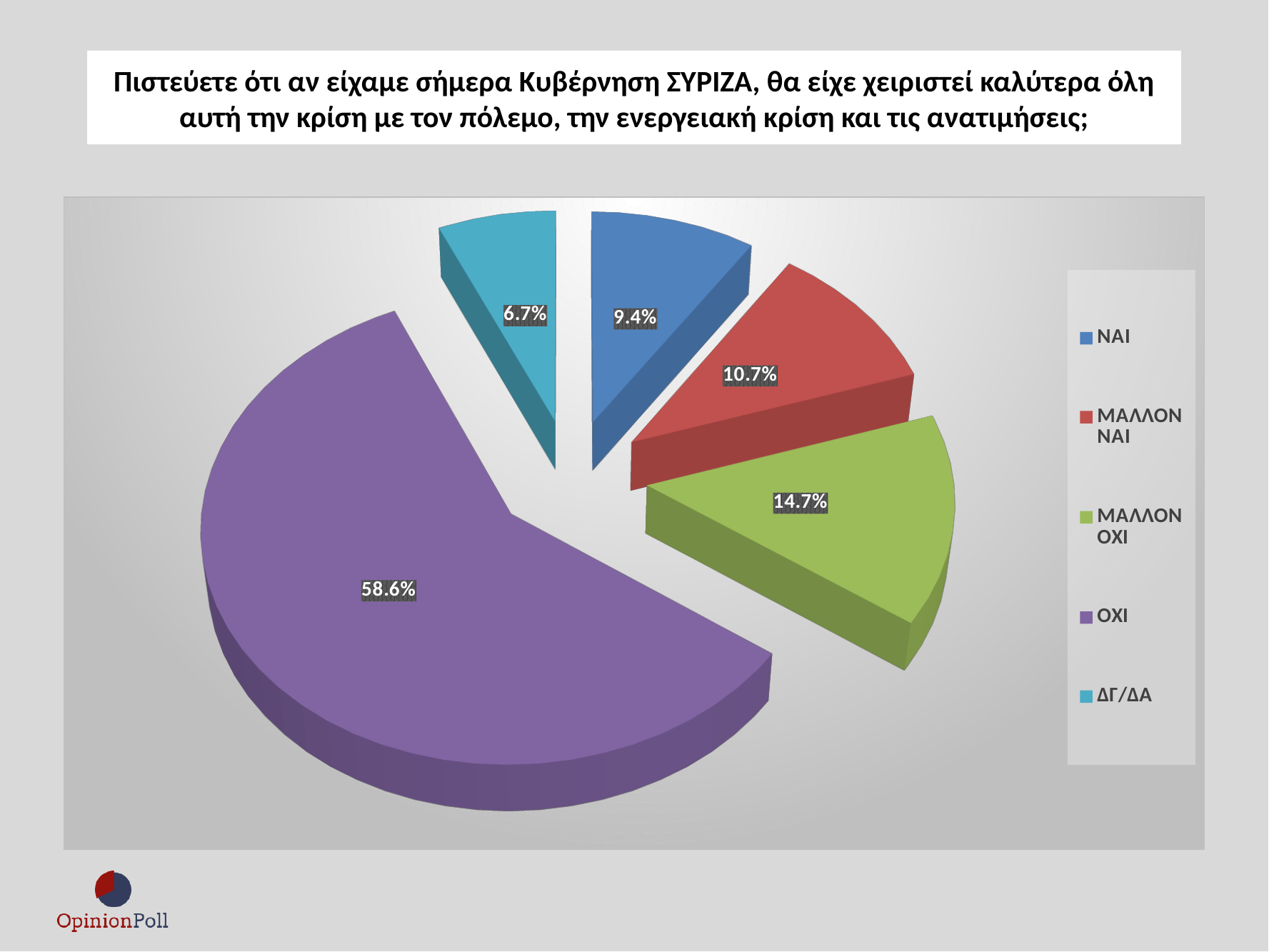
What percentage of respondents answered ΔΓ/ΔΑ? 6.7% What percentage of respondents answered ΝΑΙ? 9.4% What percentage of respondents answered ΜΑΛΛΟΝ ΝΑΙ? 10.7% What colour is the slice for ΟΧΙ? Purple Which response has the smallest share of the pie? ΔΓ/ΔΑ What kind of chart is shown on the slide? Pie chart What percentage of respondents answered ΜΑΛΛΟΝ ΟΧΙ? 14.7% Which response has the largest share of the pie? ΟΧΙ What is the difference in percentage points between ΟΧΙ and ΜΑΛΛΟΝ ΟΧΙ? 43.9 What percentage of respondents answered ΟΧΙ? 58.6% How many slices does the pie chart have? 5 Which is larger, the share for ΜΑΛΛΟΝ ΝΑΙ or the share for ΝΑΙ? ΜΑΛΛΟΝ ΝΑΙ